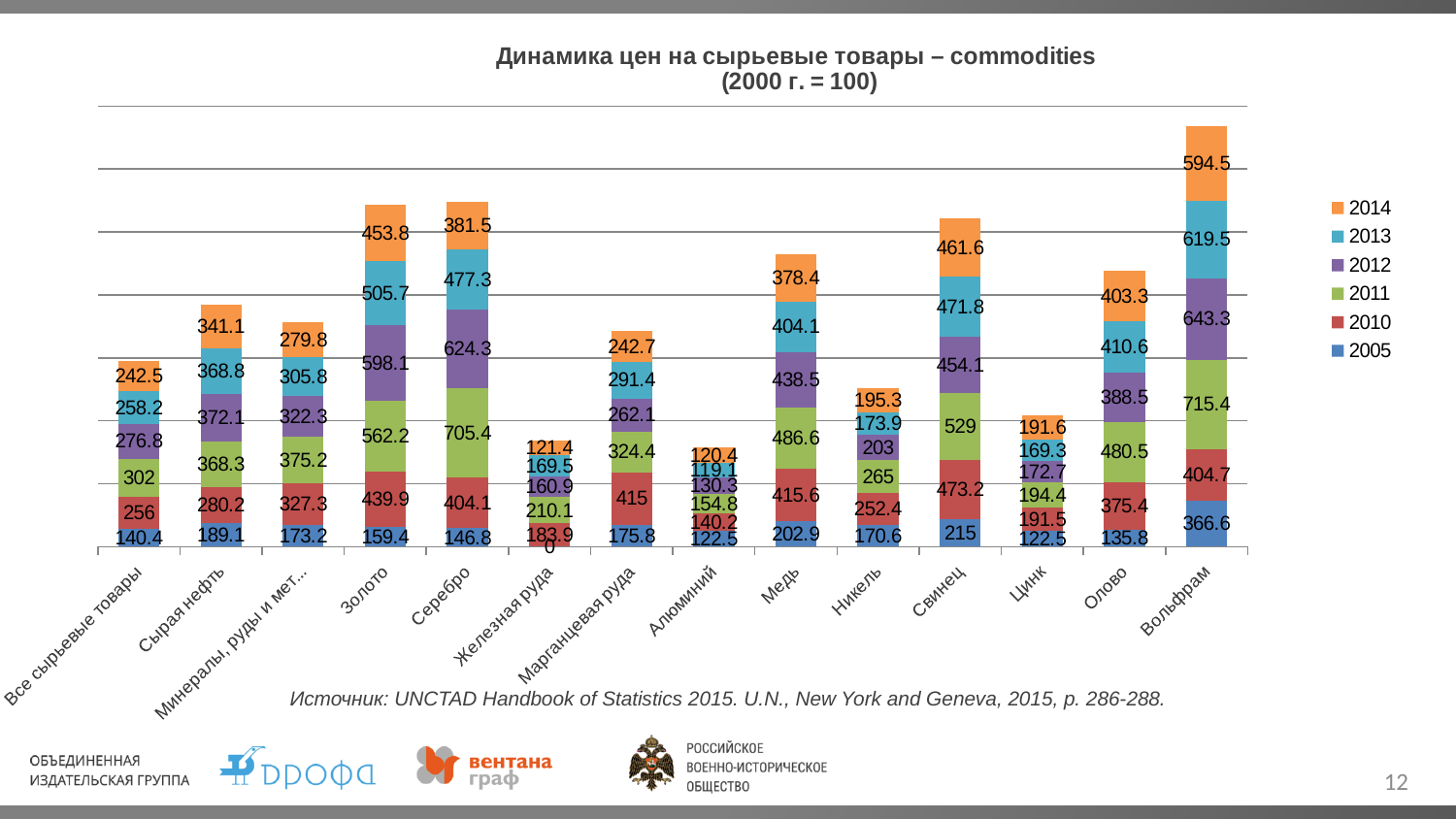
What is the total of the stacked bar for Алюминий? 787.3 What is the title of the chart? Динамика цен на сырьевые товары – commodities (2000 г. = 100) How many series does the legend list? 6 What is the 2011 value for Серебро? 705.4 Which category has the highest 2011 value? Вольфрам Which is larger for Медь: the 2011 value or the 2014 value? 2011 What is the 2005 value for Золото? 159.4 Which category has the lowest 2005 value? Железная руда What is the difference between the 2012 and 2005 values for Золото? 438.7 What is the 2014 value for Вольфрам? 594.5 What kind of chart is shown on the slide? Stacked bar chart How many categories are shown on the x axis? 14